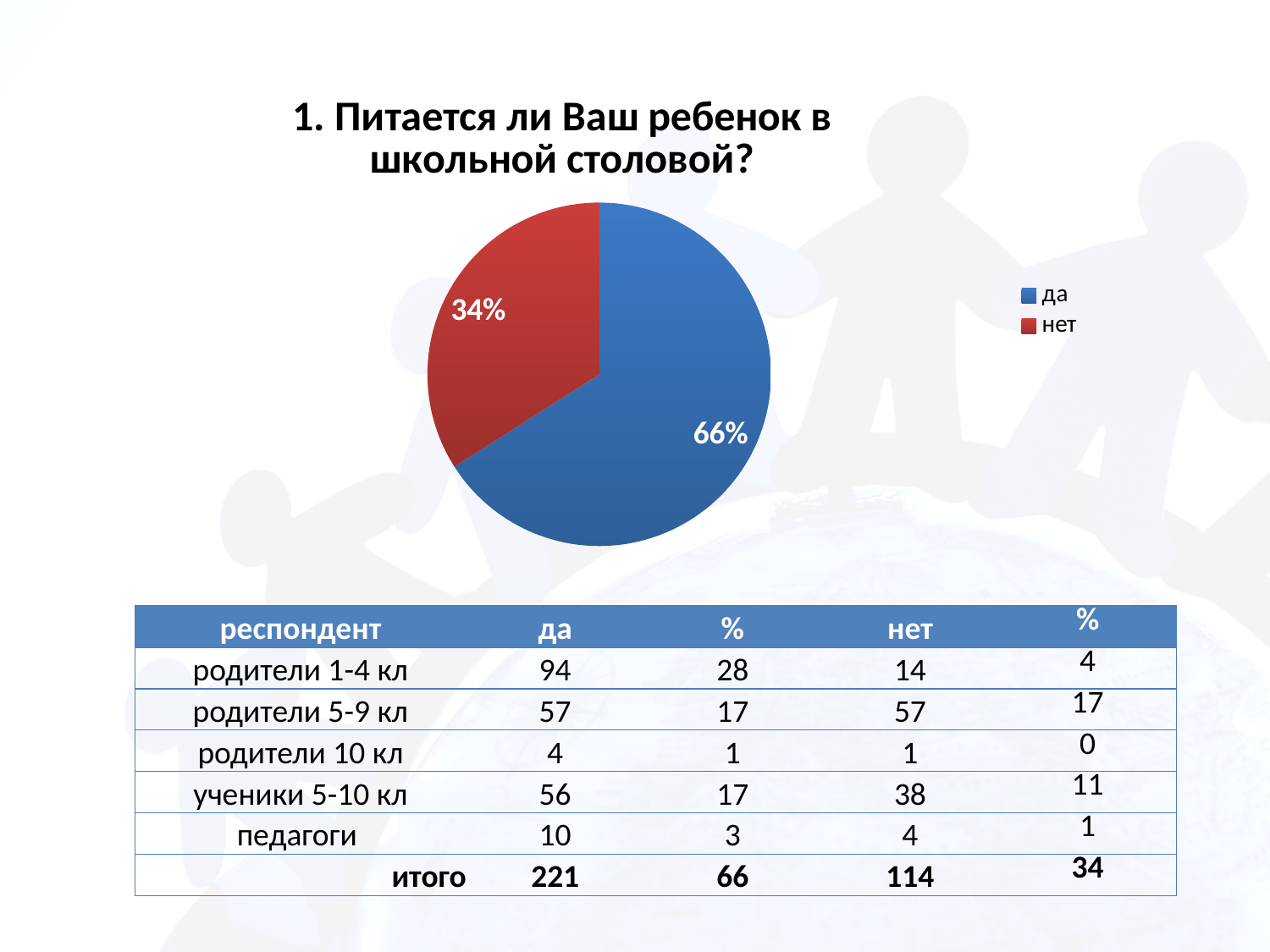
What share of the pie does the "нет" slice represent? 34% Which slice of the pie is the largest? да How many slices does the pie chart have? 2 What colour is the "нет" slice in the pie chart? red How many entries does the legend of the pie chart list? 2 What is the difference in percentage points between the "да" and "нет" slices? 32 Which slice of the pie is the smallest? нет What is the title of the pie chart? 1. Питается ли Ваш ребенок в школьной столовой? Which is larger, the "да" slice or the "нет" slice? да What share of the pie does the "да" slice represent? 66% What kind of chart is shown on the slide? pie chart